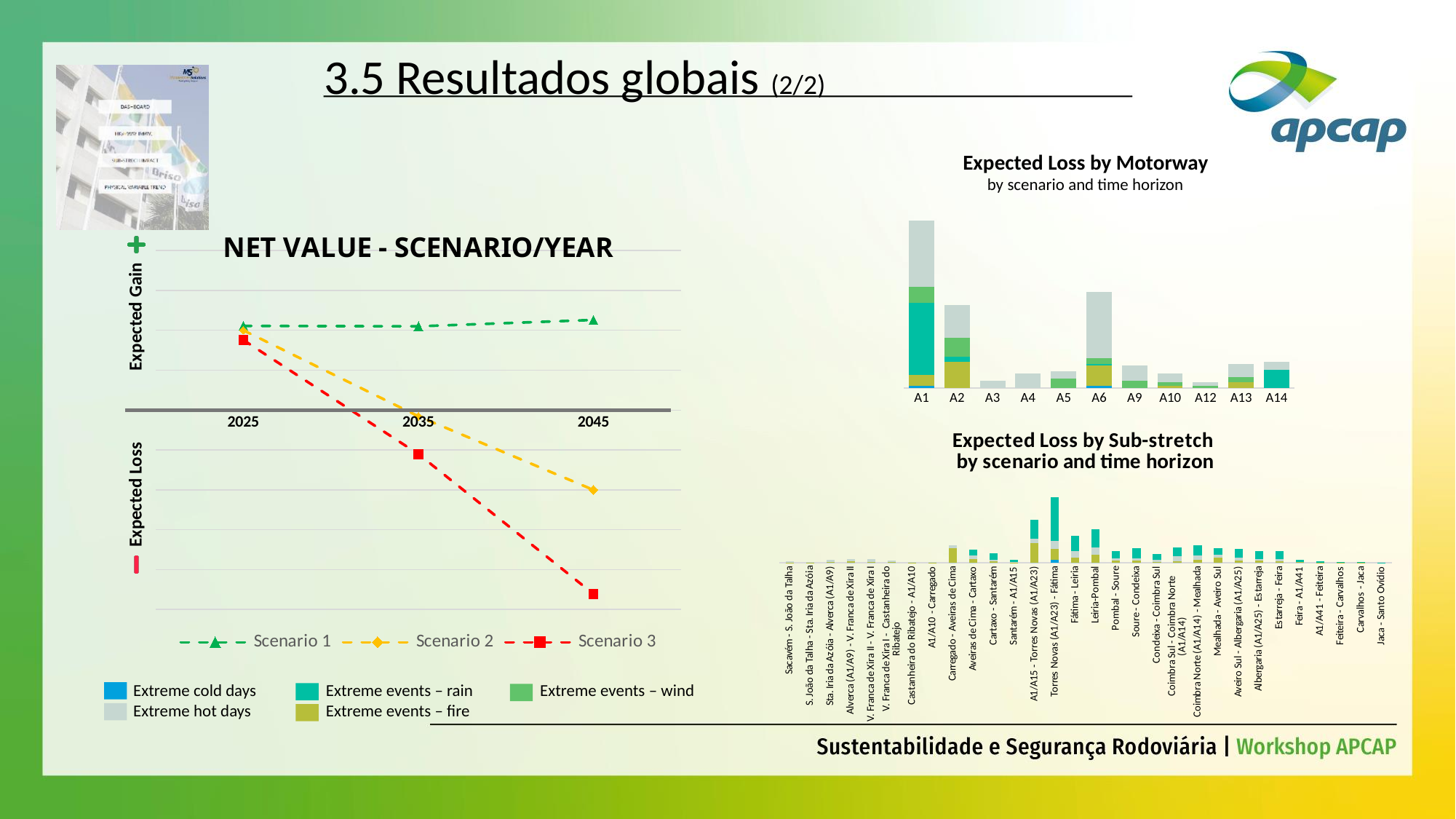
In the "NET VALUE - SCENARIO/YEAR" chart, does Scenario 3 rise or fall from 2025 to 2045? Fall How many series does the legend of the "NET VALUE - SCENARIO/YEAR" chart list? 3 What kind of chart is the "NET VALUE - SCENARIO/YEAR" chart? Line chart How many motorways are shown in the "Expected Loss by Motorway" chart? 11 In the "Expected Loss by Motorway" chart, which motorway has the highest total expected loss? A1 How many categories does the legend shared by the expected loss charts list? 5 In the "Expected Loss by Motorway" chart, which has the larger total expected loss, A2 or A6? A6 In the "Expected Loss by Sub-stretch" chart, which sub-stretch has the highest total expected loss? Torres Novas (A1/A23) - Fátima How many years are shown on the x axis of the "NET VALUE - SCENARIO/YEAR" chart? 3 What kind of chart is the "Expected Loss by Motorway" chart? Stacked bar chart In the "NET VALUE - SCENARIO/YEAR" chart, which scenario has the lowest value in 2045? Scenario 3 In the "NET VALUE - SCENARIO/YEAR" chart, which scenario has the highest value in 2045? Scenario 1